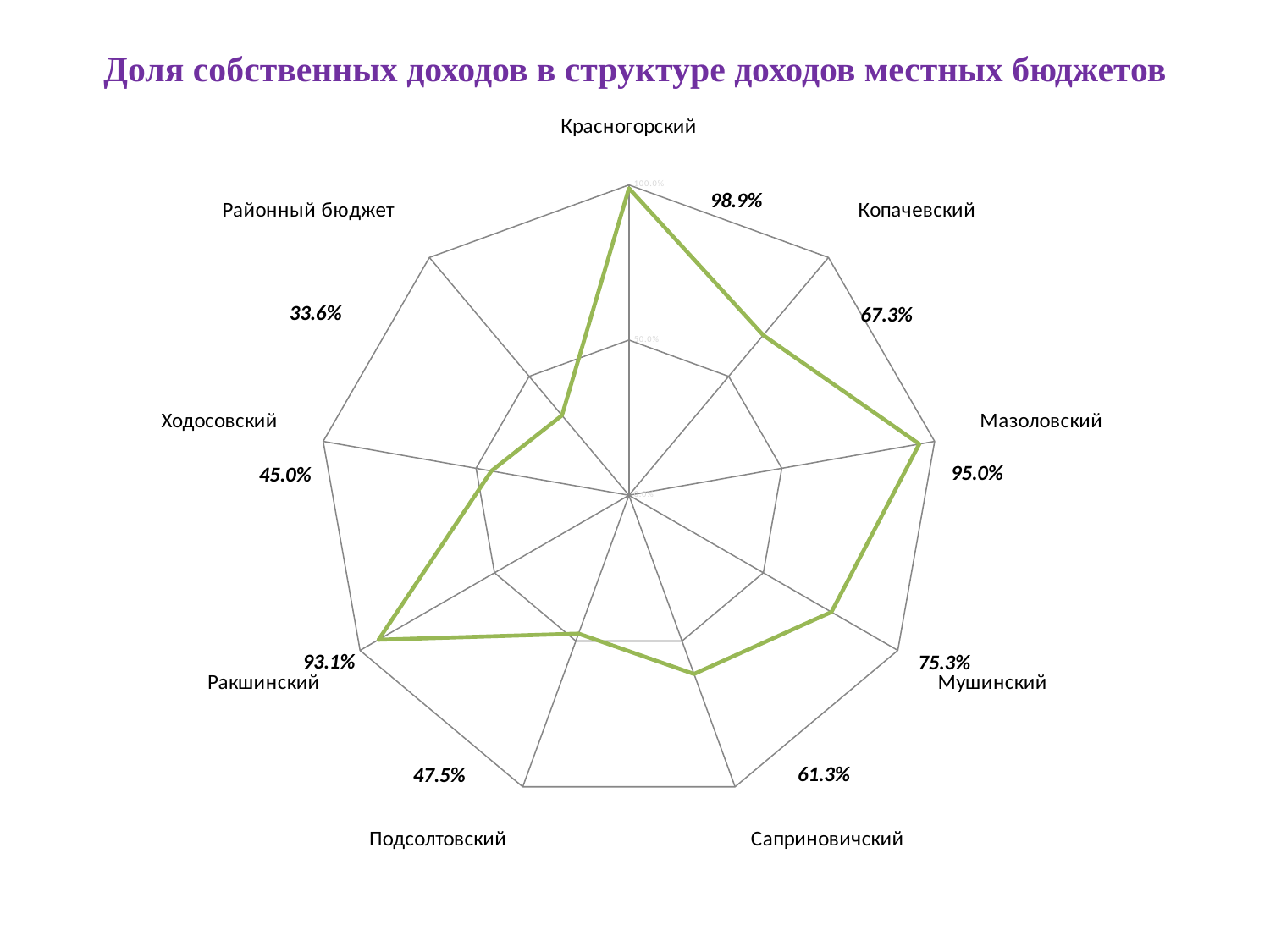
Which category has the highest value? Красногорский How many categories are plotted on the chart? 9 What kind of chart is shown on the slide? Radar chart What is the value for Мазоловский? 95.0% What is the value for Районный бюджет? 33.6% Which category has the lowest value? Районный бюджет What is the value for Подсолтовский? 47.5% What is the title of the chart? Доля собственных доходов в структуре доходов местных бюджетов What is the value for Красногорский? 98.9% What is the difference between the values for Мазоловский and Ракшинский? 1.9% Which is larger, the value for Копачевский or the value for Ходосовский? Копачевский What is the difference between the values for Мушинский and Саприновичский? 14.0%